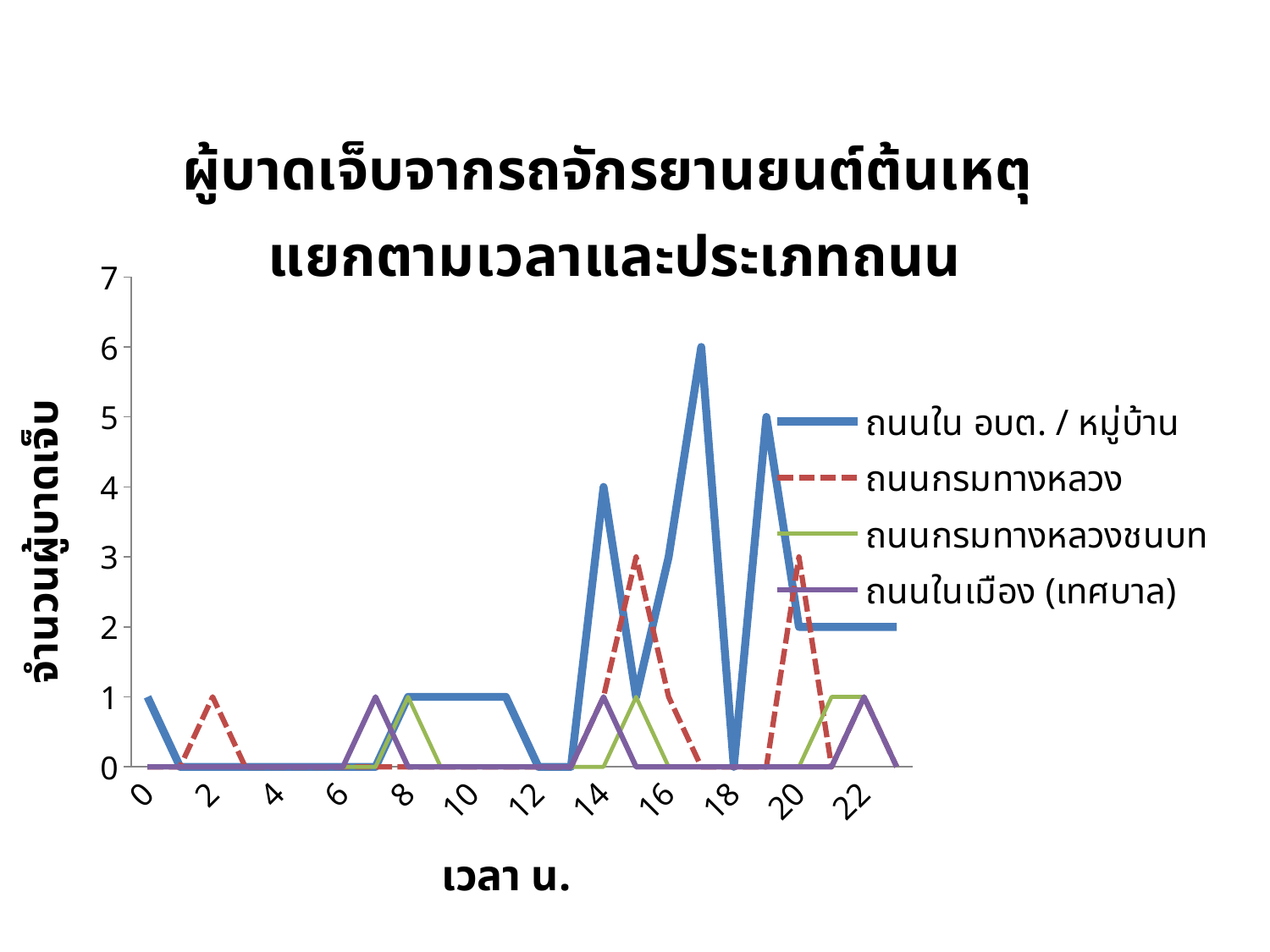
What is the difference between the peak value of ถนนใน อบต. / หมู่บ้าน and the peak value of ถนนกรมทางหลวง? 3 What is the title of the horizontal axis? เวลา น. What is the title of the vertical axis? จำนวนผู้บาดเจ็บ What is the highest value reached by the ถนนใน อบต. / หมู่บ้าน series? 6 What is the highest value reached by the ถนนกรมทางหลวงชนบท series? 1 What is the value of the ถนนใน อบต. / หมู่บ้าน series at hour 22? 2 What is the value of the ถนนใน อบต. / หมู่บ้าน series at hour 0? 1 What kind of chart is shown on the slide? line chart Which series reaches the highest value on the chart? ถนนใน อบต. / หมู่บ้าน What is the highest value reached by the ถนนกรมทางหลวง series? 3 At hour 14, which series has the larger value: ถนนใน อบต. / หมู่บ้าน or ถนนกรมทางหลวง? ถนนใน อบต. / หมู่บ้าน How many series does the legend list? 4